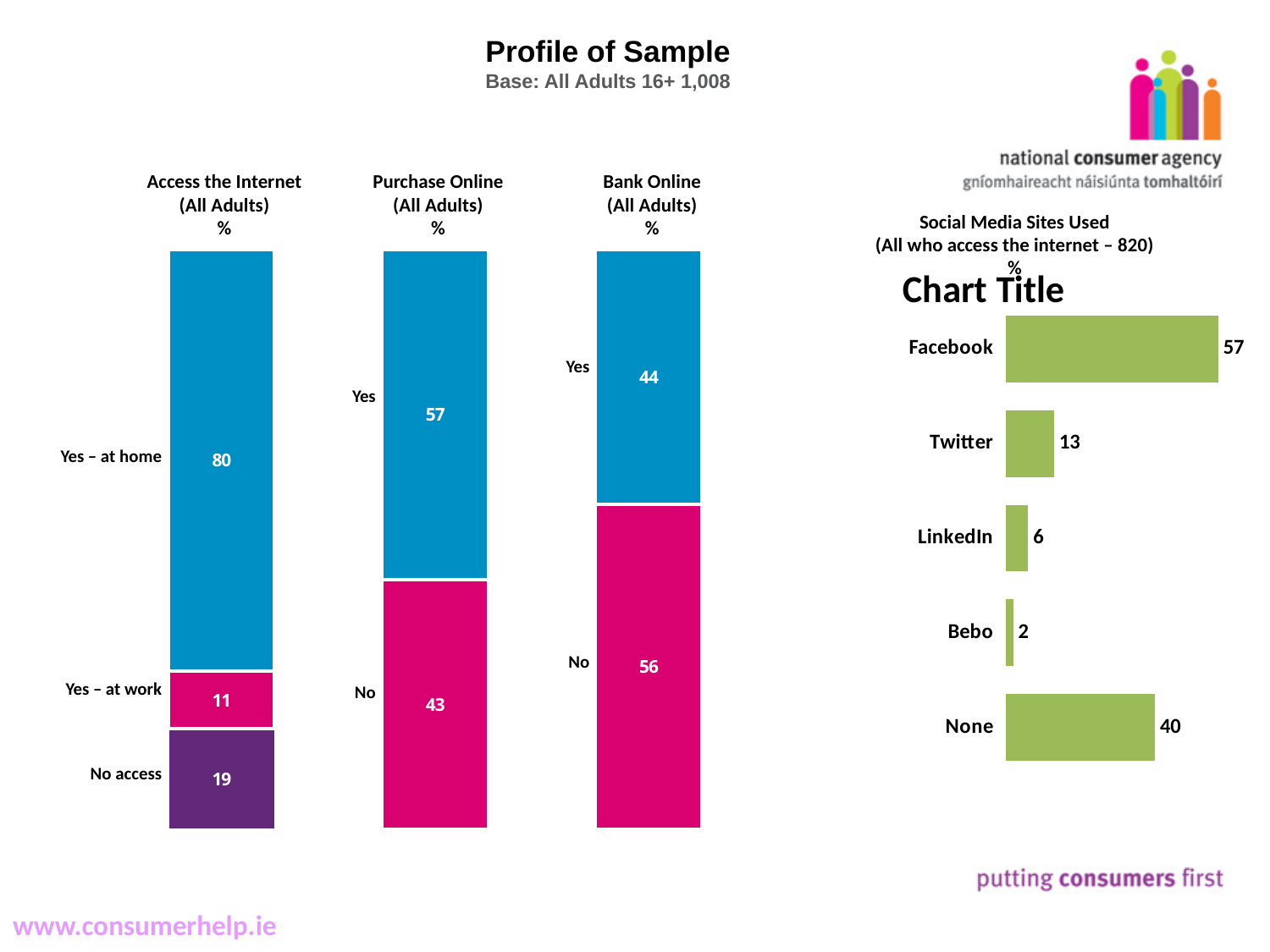
In the 'Bank Online (All Adults)' chart, what is the value for 'Yes'? 44 In the 'Access the Internet (All Adults)' chart, what is the value for 'No access'? 19 In the 'Purchase Online (All Adults)' chart, what is the difference between 'Yes' and 'No'? 14 In the 'Access the Internet (All Adults)' chart, what is the value for 'Yes – at home'? 80 In the 'Purchase Online (All Adults)' chart, what is the value for 'No'? 43 In the 'Social Media Sites Used' chart, how many categories are shown? 5 In the 'Social Media Sites Used' chart, what is the value for 'Twitter'? 13 In the 'Bank Online (All Adults)' chart, which is larger, 'Yes' or 'No'? No In the 'Access the Internet (All Adults)' chart, what is the total of the three segments? 110 In the 'Social Media Sites Used' chart, which site has the highest value? Facebook In the 'Social Media Sites Used' chart, which category has the lowest value? Bebo What kind of chart is the 'Social Media Sites Used' chart? Bar chart